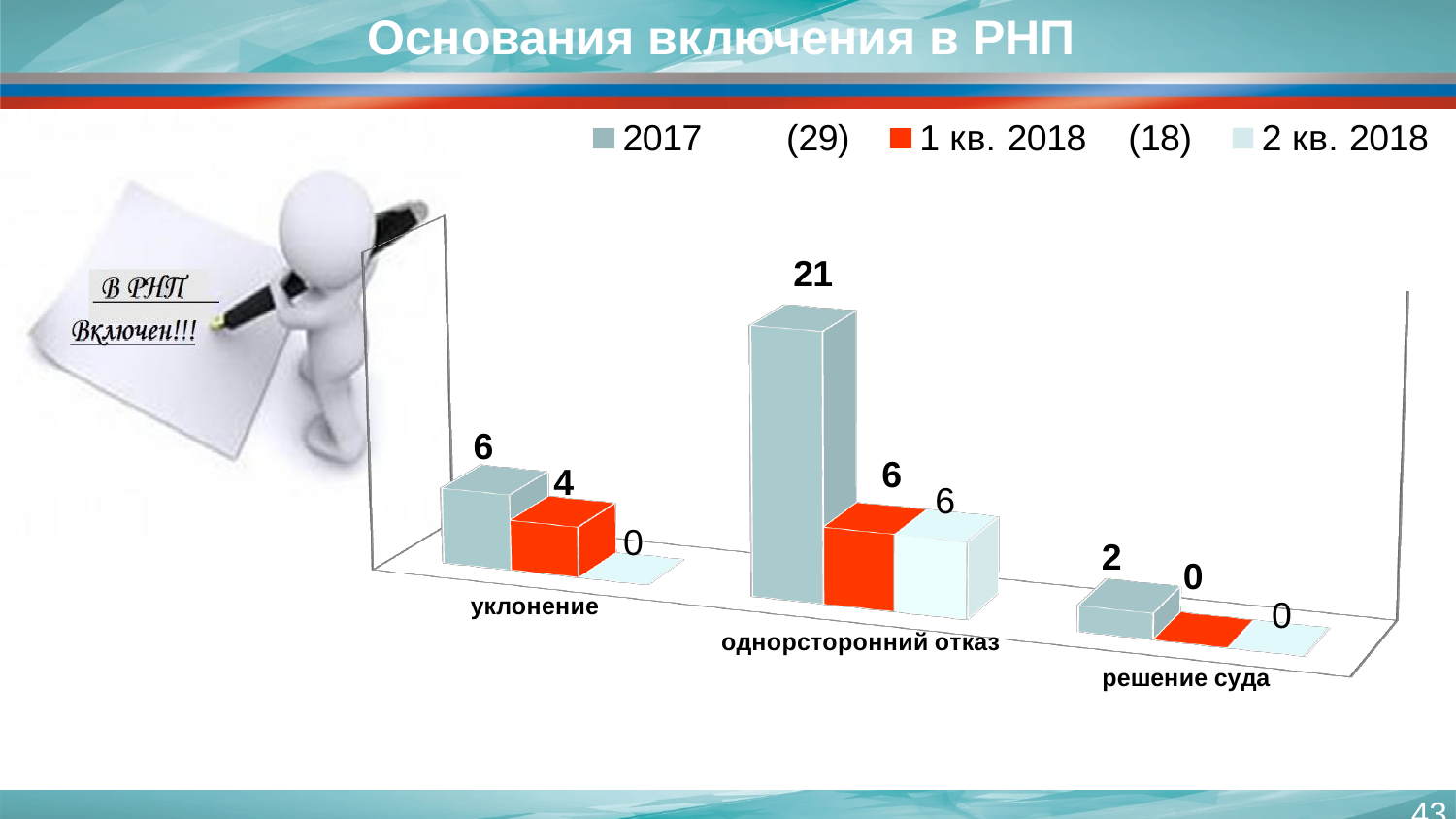
Which is larger in the 'уклонение' category: the 2017 value or the '1 кв. 2018' value? 2017 What is the value for '2 кв. 2018' in the 'односторонний отказ' category? 6 What is the value for 2017 in the 'решение суда' category? 2 Which category has the lowest value for the 2017 series? решение суда Which category has the highest value for the 2017 series? односторонний отказ What is the title of the slide containing the chart? Основания включения в РНП How many series does the chart legend list? 3 What is the value for 2017 in the 'односторонний отказ' category? 21 What is the difference between the 2017 value and the '1 кв. 2018' value in the 'односторонний отказ' category? 15 What kind of chart is shown on the slide? bar chart What is the value for '1 кв. 2018' in the 'уклонение' category? 4 How many categories are shown on the x axis of the chart? 3